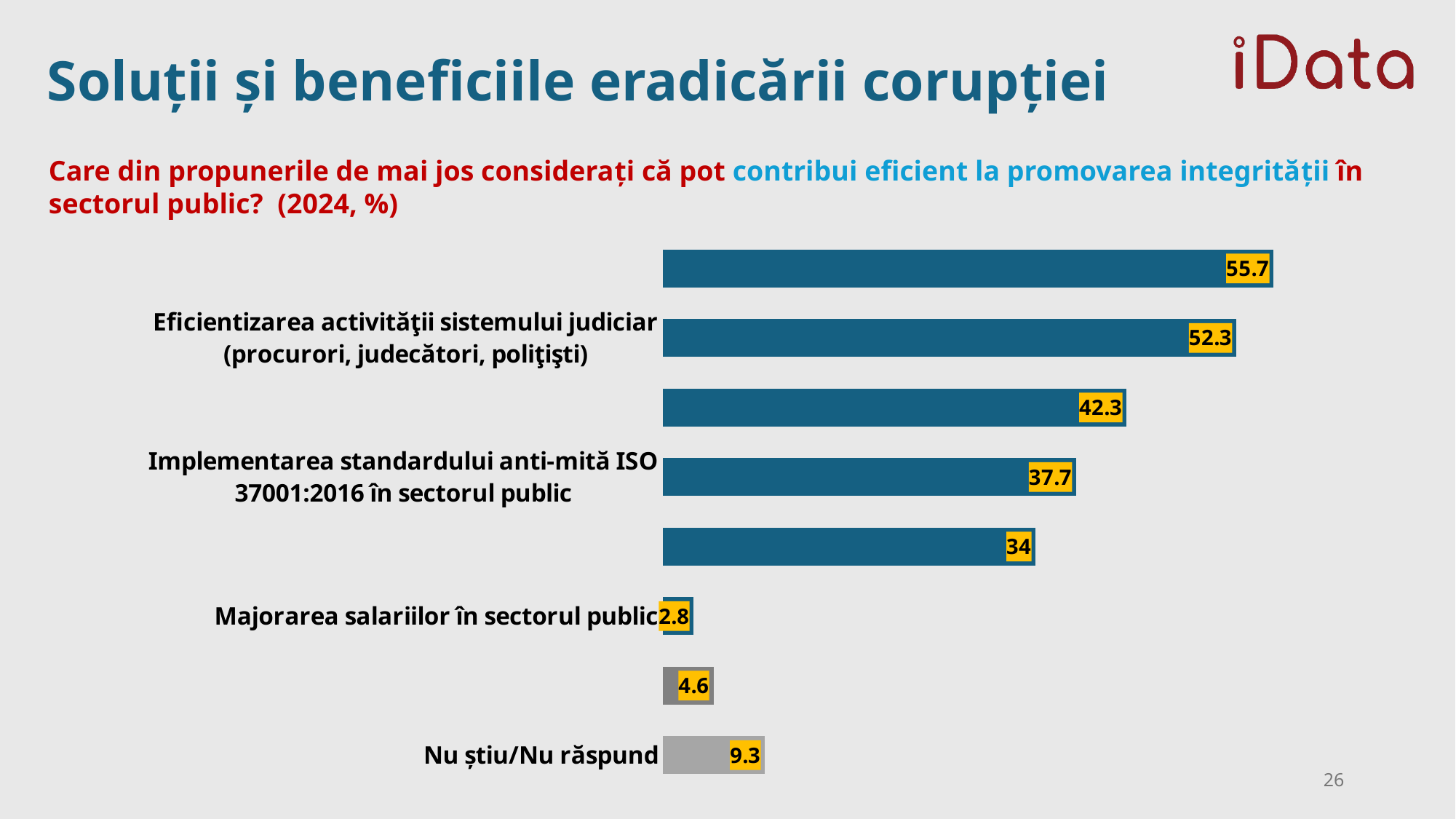
What is the value for "Majorarea salariilor în sectorul public"? 2.8 What kind of chart is shown on the slide? Bar chart Which has the higher value: "Eficientizarea activităţii sistemului judiciar" or "Implementarea standardului anti-mită ISO 37001:2016 în sectorul public"? Eficientizarea activităţii sistemului judiciar What is the difference between the values for "Nu știu/Nu răspund" and "Majorarea salariilor în sectorul public"? 6.5 What is the largest value shown on the chart? 55.7 What is the difference between the values for "Eficientizarea activităţii sistemului judiciar" and "Implementarea standardului anti-mită ISO 37001:2016 în sectorul public"? 14.6 What is the value for "Implementarea standardului anti-mită ISO 37001:2016 în sectorul public"? 37.7 What is the value for "Nu știu/Nu răspund"? 9.3 What is the smallest value shown on the chart? 2.8 Which has the lower value: "Majorarea salariilor în sectorul public" or "Nu știu/Nu răspund"? Majorarea salariilor în sectorul public What is the value for "Eficientizarea activităţii sistemului judiciar (procurori, judecători, poliţişti)"? 52.3 How many bars are shown on the chart? 8